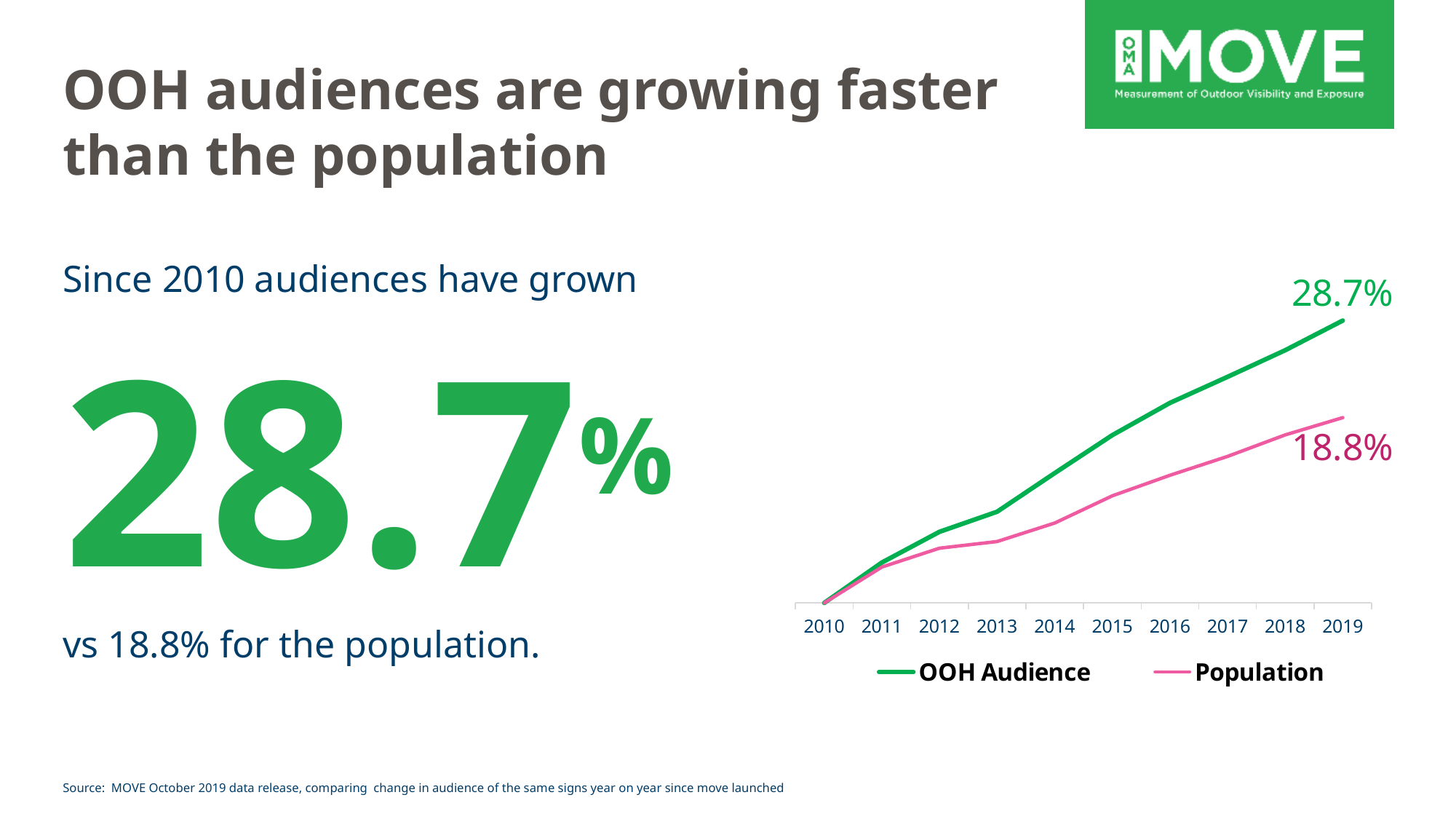
Does the Population series rise or fall from 2010 to 2019? rise What is the value of the Population series in 2019? 18.8% What is the value of the OOH Audience series in 2019? 28.7% How many years are shown on the x axis of the chart? 10 How many series does the chart legend list? 2 What are the two series named in the chart legend? OOH Audience and Population Does the OOH Audience series rise or fall from 2010 to 2019? rise What type of chart is shown on the slide? line chart Which colour is used for the OOH Audience line? green What is the difference between the OOH Audience and Population values in 2019? 9.9% What is the first year shown on the x axis of the chart? 2010 Which series has the higher value in 2019, OOH Audience or Population? OOH Audience